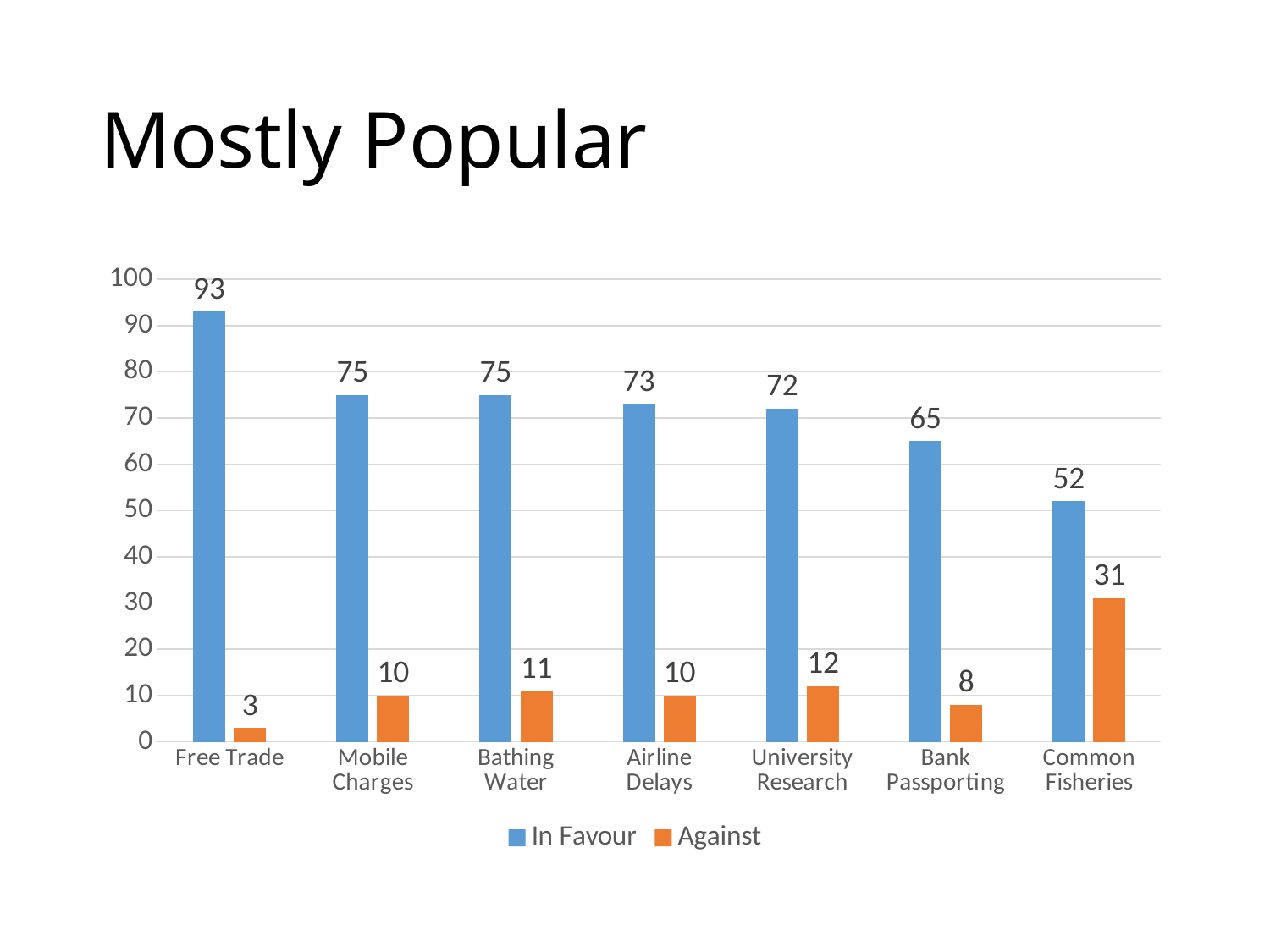
How many series does the legend list? 2 What is the title of the slide? Mostly Popular What is the difference between the In Favour and Against values for Common Fisheries? 21 What is the Against value for Common Fisheries? 31 What is the Against value for Bank Passporting? 8 Which is larger: the Against value for University Research or the Against value for Bathing Water? University Research What kind of chart is shown on the slide? Bar chart Which category has the lowest In Favour value? Common Fisheries Which category has the lowest Against value? Free Trade How many categories are shown on the x axis? 7 Which category has the highest In Favour value? Free Trade What is the In Favour value for Free Trade? 93